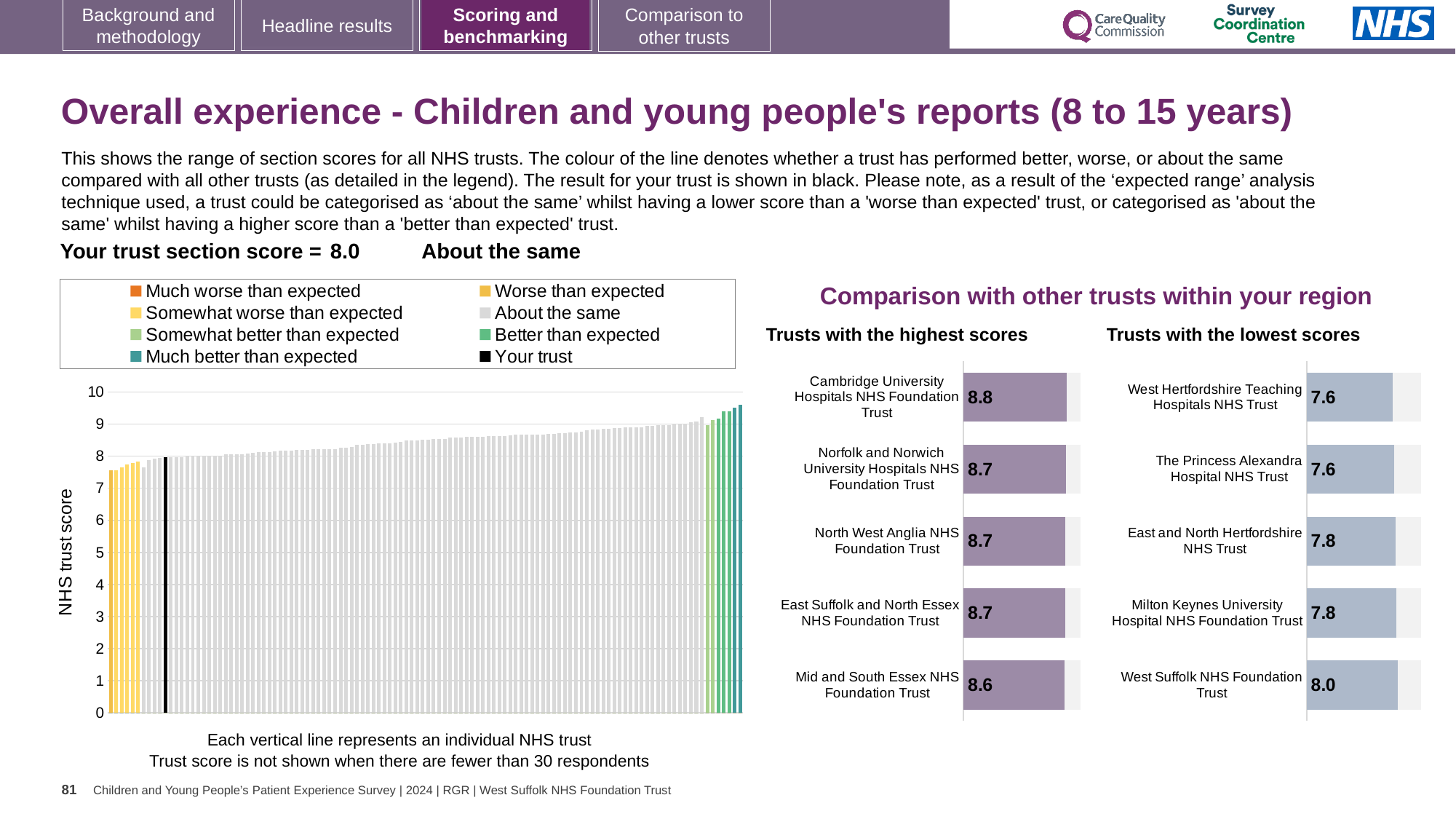
In the 'Trusts with the highest scores' chart, which trust has the lowest score? Mid and South Essex NHS Foundation Trust In the 'Trusts with the lowest scores' chart, what is the score for West Suffolk NHS Foundation Trust? 8.0 In the large chart on the left, do the trust scores rise or fall from left to right along the x axis? rise What kind of chart is the large chart on the left showing NHS trust scores? bar chart In the 'Trusts with the highest scores' chart, what is the difference between the scores of Cambridge University Hospitals NHS Foundation Trust and Mid and South Essex NHS Foundation Trust? 0.2 How many entries does the legend above the large chart on the left list? 8 In the 'Trusts with the highest scores' chart, what is the score for Cambridge University Hospitals NHS Foundation Trust? 8.8 In the 'Trusts with the lowest scores' chart, which trust has the highest score? West Suffolk NHS Foundation Trust In the large chart on the left, is the value of the shortest bar greater or less than 8? less How many trusts are shown in the 'Trusts with the lowest scores' chart? 5 What is the label on the y axis of the large chart on the left? NHS trust score In the large chart on the left, is the value of the tallest bar greater or less than 9? greater